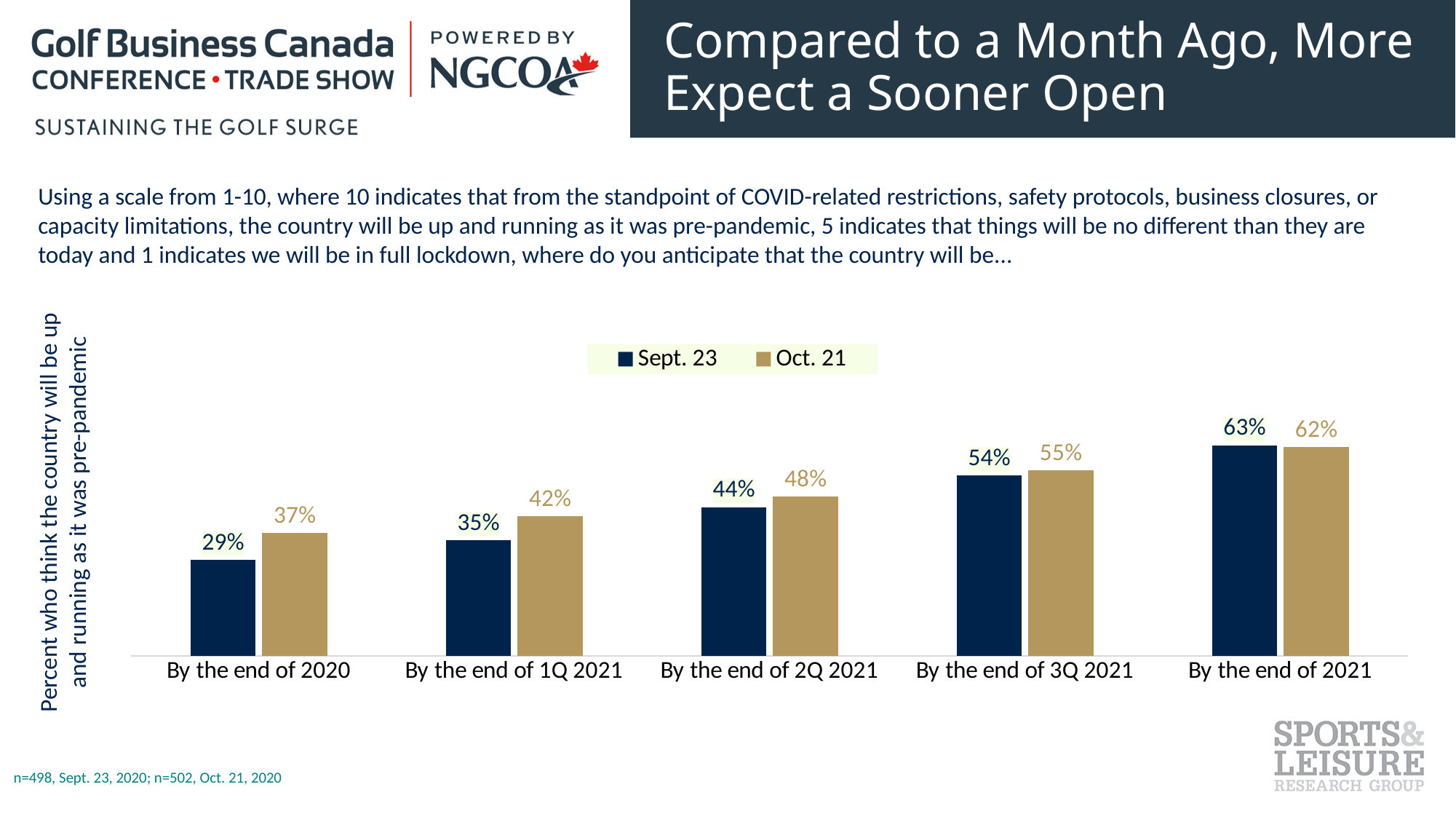
What is the Oct. 21 value for "By the end of 2020"? 37% What is the Sept. 23 value for "By the end of 2Q 2021"? 44% How many categories are shown on the x axis? 5 Which category has the lowest Oct. 21 value? By the end of 2020 For "By the end of 2021", which series has the larger value, Sept. 23 or Oct. 21? Sept. 23 What kind of chart is shown on the slide? Bar chart Do the Sept. 23 values rise or fall from left to right along the x axis? Rise What is the difference between the Oct. 21 and Sept. 23 values for "By the end of 1Q 2021"? 7% What is the difference between the Oct. 21 and Sept. 23 values for "By the end of 2020"? 8% What is the Oct. 21 value for "By the end of 3Q 2021"? 55% Which category has the highest Sept. 23 value? By the end of 2021 How many series does the legend list? 2